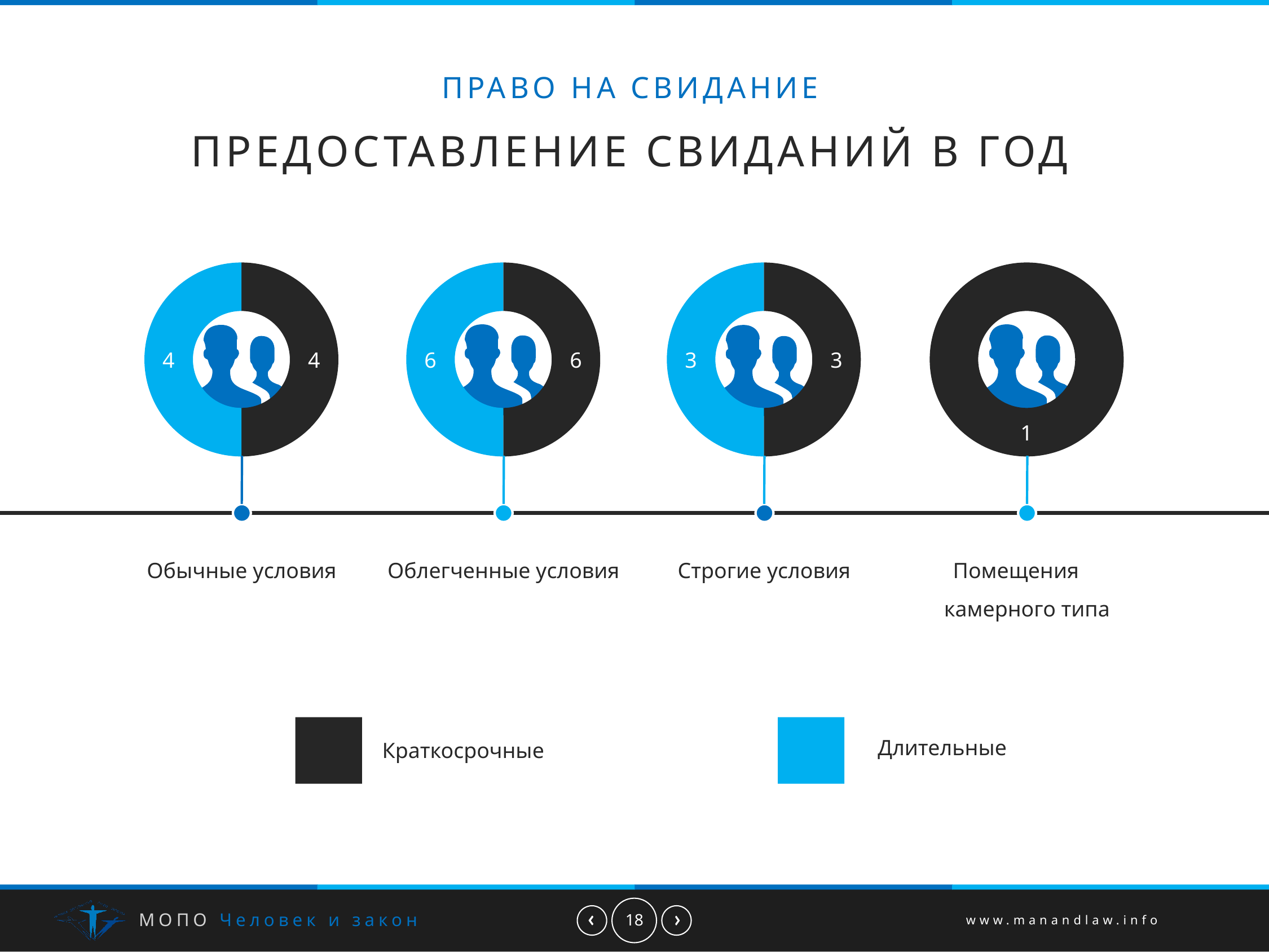
Which category has the highest number of Длительные visits? Облегченные условия Which category has the lowest number of Краткосрочные visits? Помещения камерного типа What kind of chart is used for each of the four categories on the slide? Donut (pie) chart In the chart for Помещения камерного типа, how many Краткосрочные visits are shown? 1 What are the two series named in the legend? Краткосрочные and Длительные Which colour represents Длительные visits in the charts? Blue In the chart for Строгие условия, how many Краткосрочные visits are shown? 3 What is the difference between the Краткосрочные visits for Облегченные условия and Строгие условия? 3 In the chart for Обычные условия, how many Краткосрочные visits are shown? 4 In the chart for Облегченные условия, how many Длительные visits are shown? 6 How many series does the legend list? 2 How many donut charts are shown on the slide? 4